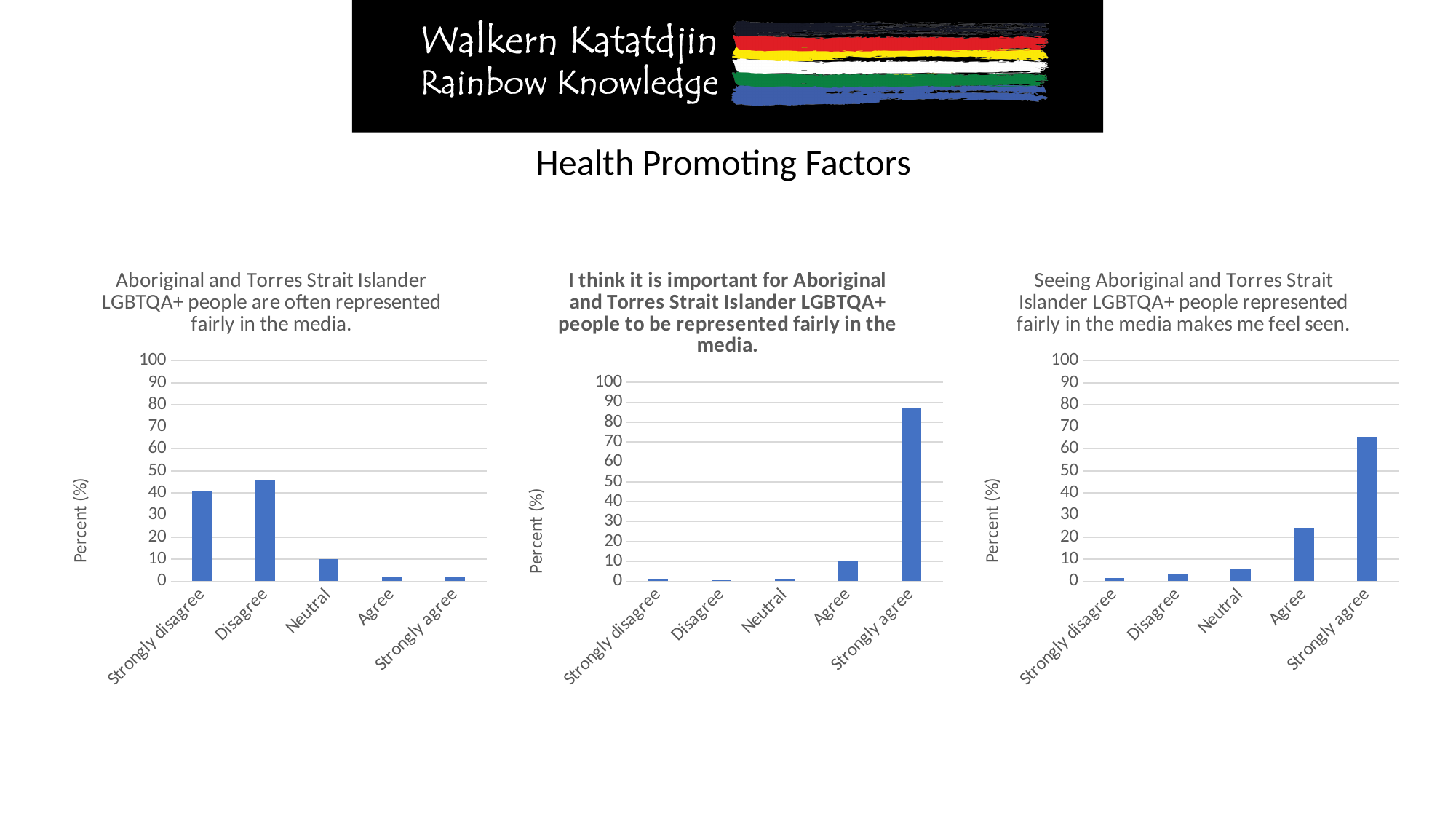
In the right chart ("...makes me feel seen."), is the value for Agree greater or less than 20? greater In the right chart ("Seeing Aboriginal and Torres Strait Islander LGBTQA+ people represented fairly in the media makes me feel seen."), which response category has the highest value? Strongly agree In the left chart ("...often represented fairly in the media."), is the value for Disagree greater or less than 40? greater In the right chart ("...makes me feel seen."), do the values rise or fall moving from Strongly disagree to Strongly agree along the x axis? rise In the left chart ("...often represented fairly in the media."), is the value for Neutral greater or less than 20? less In the left chart ("...often represented fairly in the media."), which is larger, the value for Strongly disagree or the value for Neutral? Strongly disagree In the left chart ("Aboriginal and Torres Strait Islander LGBTQA+ people are often represented fairly in the media."), which response category has the highest value? Disagree How many response categories are shown on the x axis of the right chart ("...makes me feel seen.")? 5 What kind of chart is the middle chart ("I think it is important...")? bar chart In the middle chart ("I think it is important..."), which is larger, the value for Agree or the value for Neutral? Agree In the middle chart ("I think it is important for Aboriginal and Torres Strait Islander LGBTQA+ people to be represented fairly in the media."), which response category has the highest value? Strongly agree